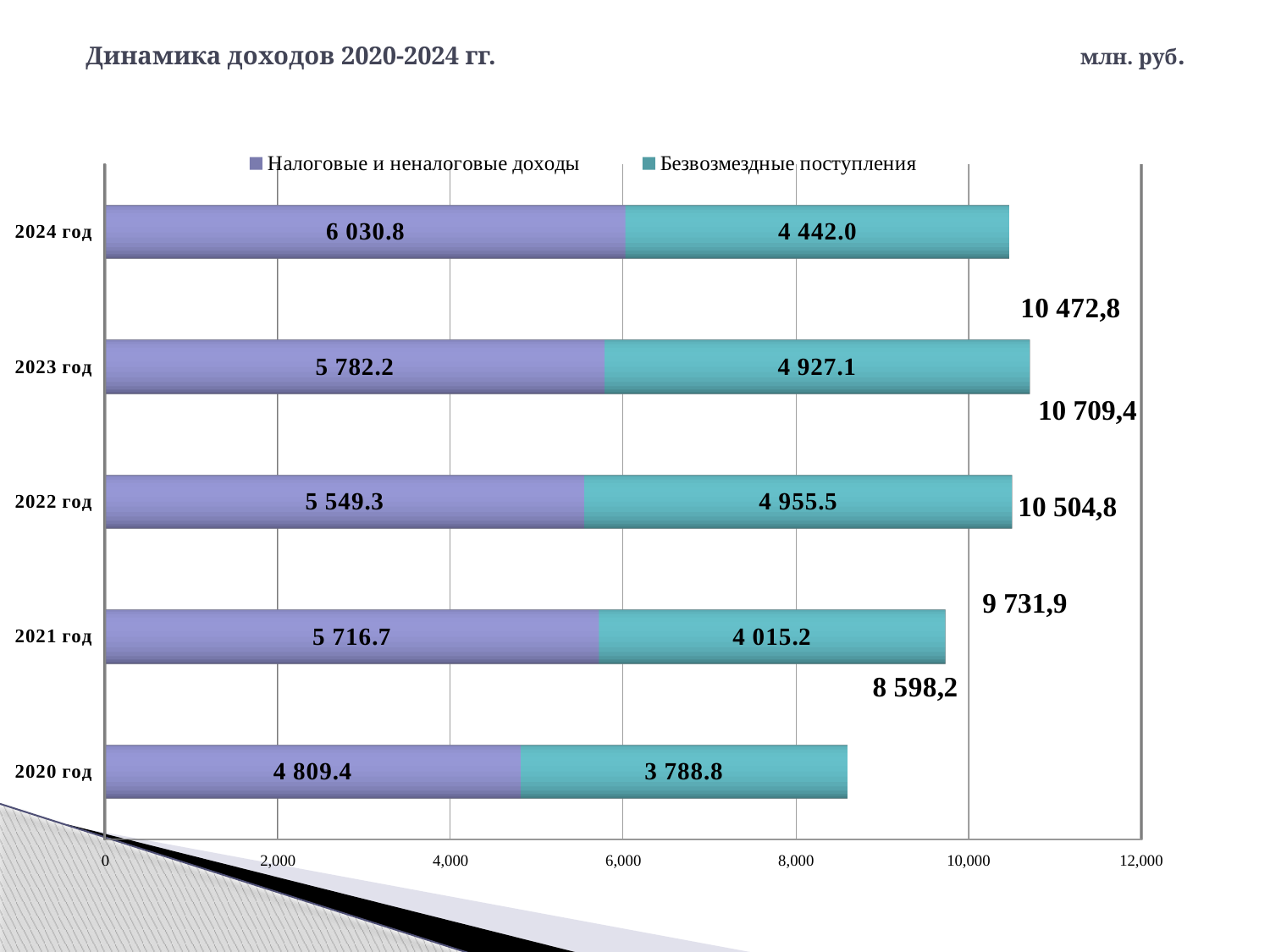
What is the total income for 2024 год? 10 472,8 What is the value of Налоговые и неналоговые доходы for 2024 год? 6 030.8 What kind of chart is shown on the slide? Stacked bar chart What is the difference between Налоговые и неналоговые доходы in 2024 год and 2023 год? 248.6 Which year has the larger value of Налоговые и неналоговые доходы, 2022 год or 2021 год? 2021 год Is the total income for 2020 год greater or less than 8,000? greater How many years are shown on the chart? 5 What is the title of the chart? Динамика доходов 2020-2024 гг. Which year has the highest value of Безвозмездные поступления? 2022 год How many series does the legend list? 2 Which year has the lowest value of Налоговые и неналоговые доходы? 2020 год What is the value of Безвозмездные поступления for 2021 год? 4 015.2